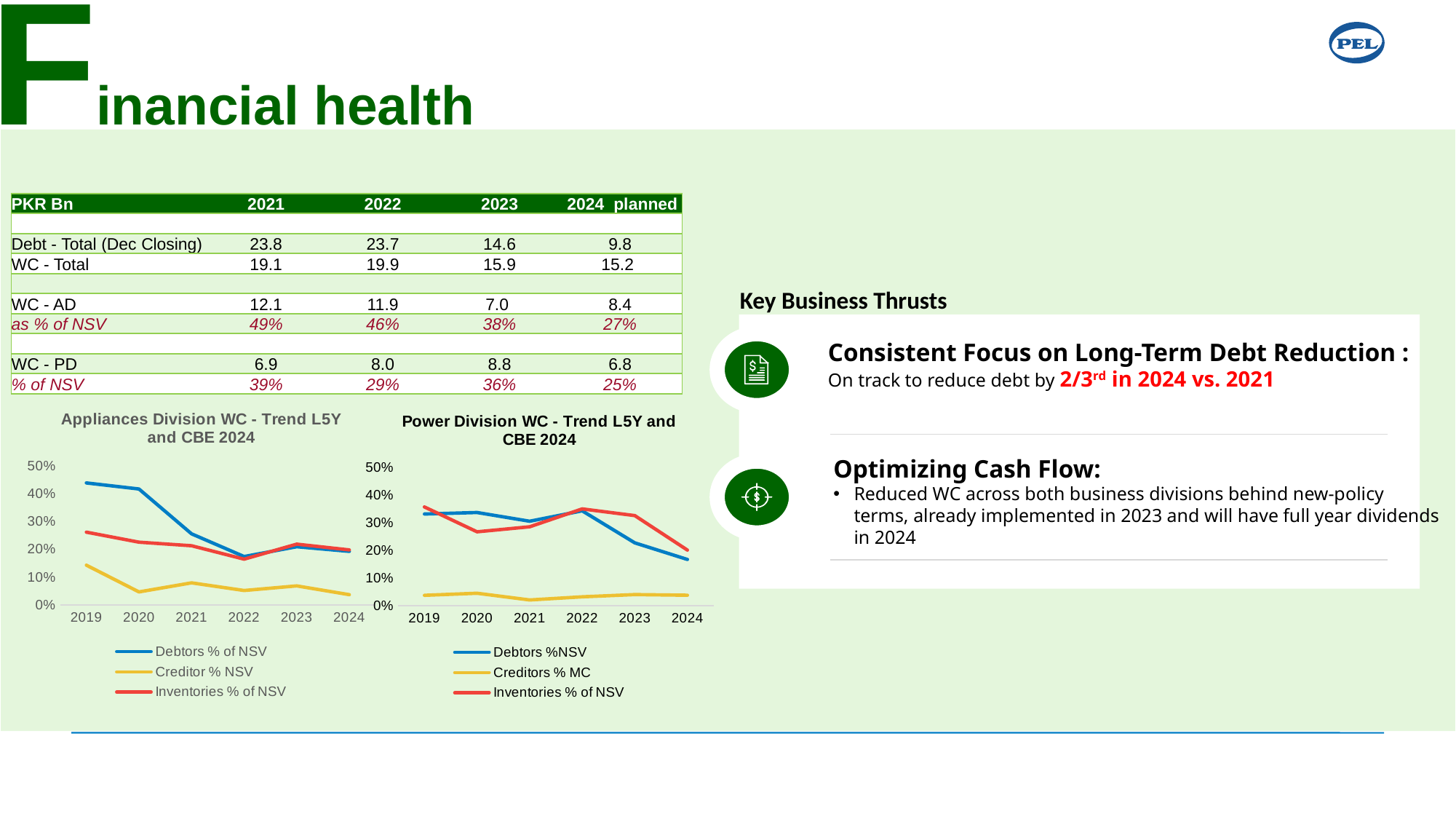
In the 'Appliances Division WC - Trend L5Y and CBE 2024' chart, which is larger in 2019: Debtors % of NSV or Inventories % of NSV? Debtors % of NSV In the 'Power Division WC - Trend L5Y and CBE 2024' chart, which series has the lowest value in 2024? Creditors % MC What type of chart is the 'Appliances Division WC - Trend L5Y and CBE 2024' chart? Line chart In the 'Appliances Division WC - Trend L5Y and CBE 2024' chart, is the value for Debtors % of NSV in 2019 greater or less than 40%? greater In the 'Power Division WC - Trend L5Y and CBE 2024' chart, which is larger in 2024: Inventories % of NSV or Debtors %NSV? Inventories % of NSV In the 'Power Division WC - Trend L5Y and CBE 2024' chart, is the value for Inventories % of NSV in 2019 greater or less than 30%? greater In the 'Appliances Division WC - Trend L5Y and CBE 2024' chart, which series has the highest value in 2019? Debtors % of NSV What colour is the Creditor % NSV line in the 'Appliances Division WC - Trend L5Y and CBE 2024' chart? Yellow How many years are shown on the x axis of the 'Appliances Division WC - Trend L5Y and CBE 2024' chart? 6 In the 'Appliances Division WC - Trend L5Y and CBE 2024' chart, does Debtors % of NSV rise or fall from 2019 to 2024? Fall In the 'Power Division WC - Trend L5Y and CBE 2024' chart, is the value for Debtors %NSV in 2024 greater or less than 20%? less How many series does the legend of the 'Power Division WC - Trend L5Y and CBE 2024' chart list? 3